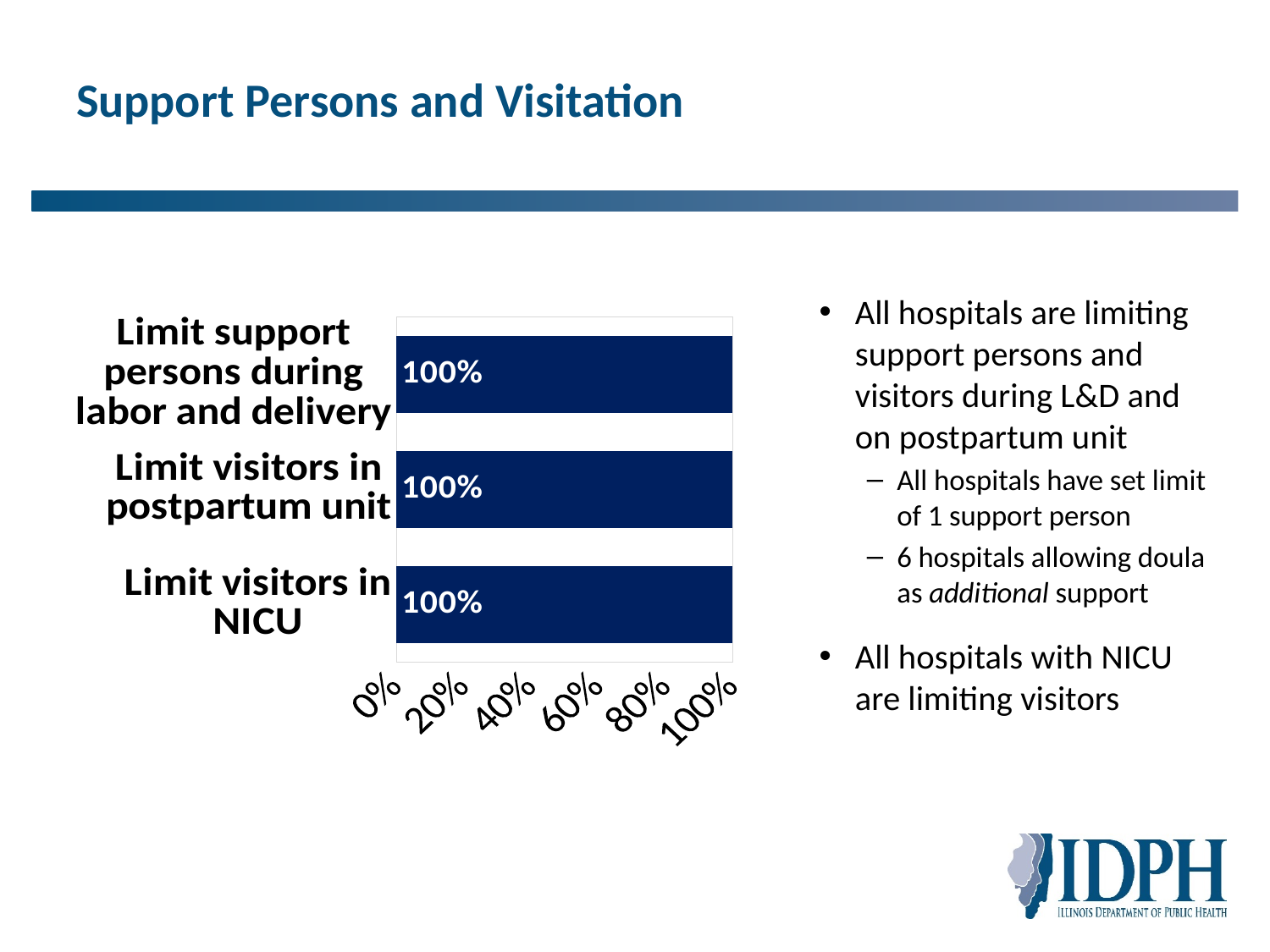
Do all three bars in the chart have the same value? Yes What is the difference between the values for "Limit visitors in NICU" and "Limit visitors in postpartum unit"? 0% Is the value for "Limit visitors in NICU" greater or less than 80%? greater What kind of chart is shown on the slide? Bar chart What is the highest value shown on the x axis of the chart? 100% How many categories are shown in the chart? 3 What is the value for "Limit support persons during labor and delivery"? 100% What is the value for "Limit visitors in NICU"? 100% Is the value for "Limit support persons during labor and delivery" greater or less than 60%? greater What is the value for "Limit visitors in postpartum unit"? 100% What colour are the bars in the chart? Dark blue